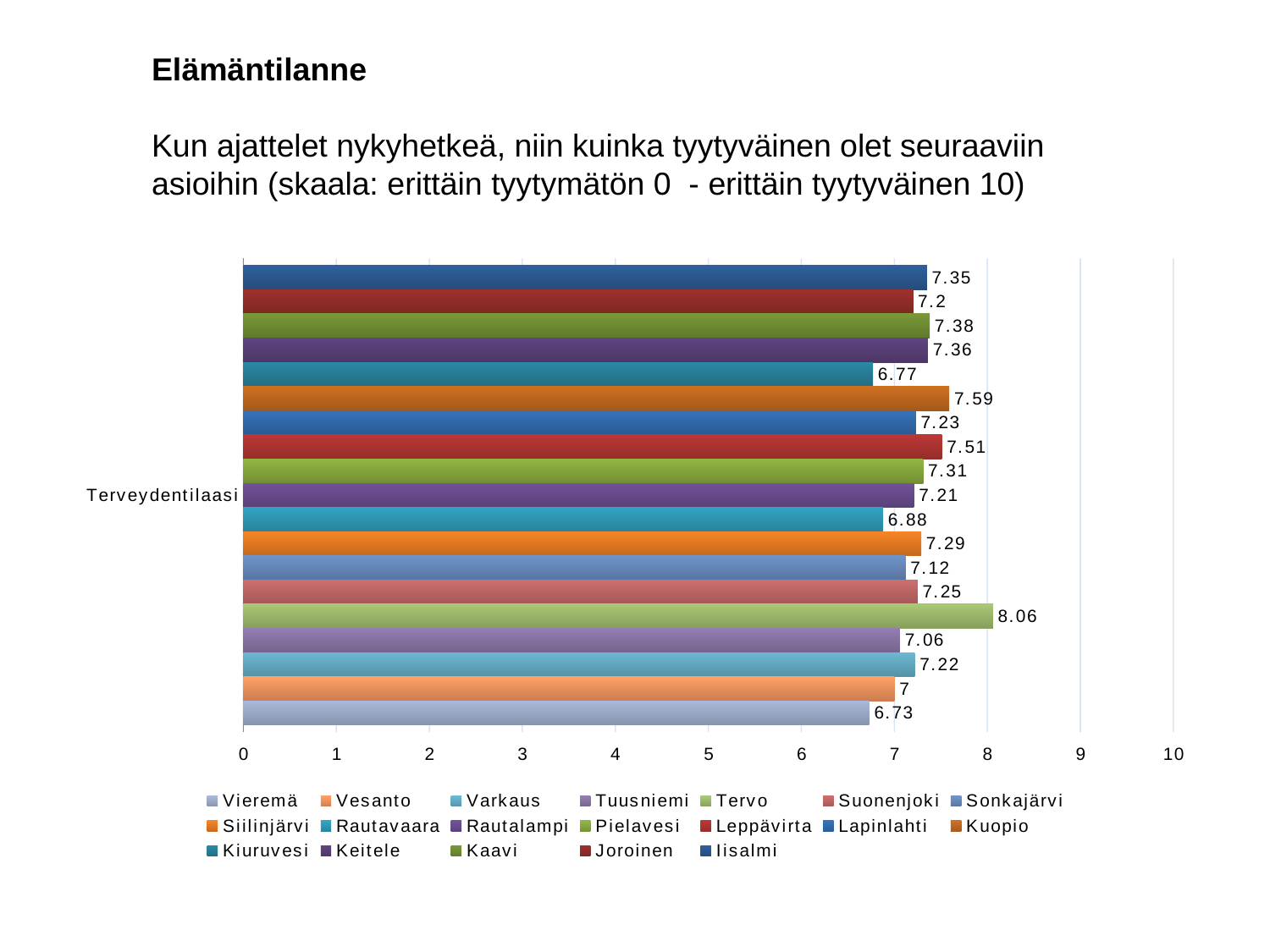
What is the difference between the values for Tervo and Vieremä? 1.33 What is the category label shown on the vertical axis? Terveydentilaasi What is the value for Kuopio? 7.59 Which municipality has the highest value for Terveydentilaasi? Tervo How many series does the legend list? 19 Which is larger, the value for Kuopio or the value for Leppävirta? Kuopio Is the value for Tervo greater or less than 8? greater What is the value for Vieremä? 6.73 What is the value for Tervo? 8.06 Which municipality has the lowest value for Terveydentilaasi? Vieremä What is the value for Vesanto? 7 What kind of chart is shown on the slide? bar chart